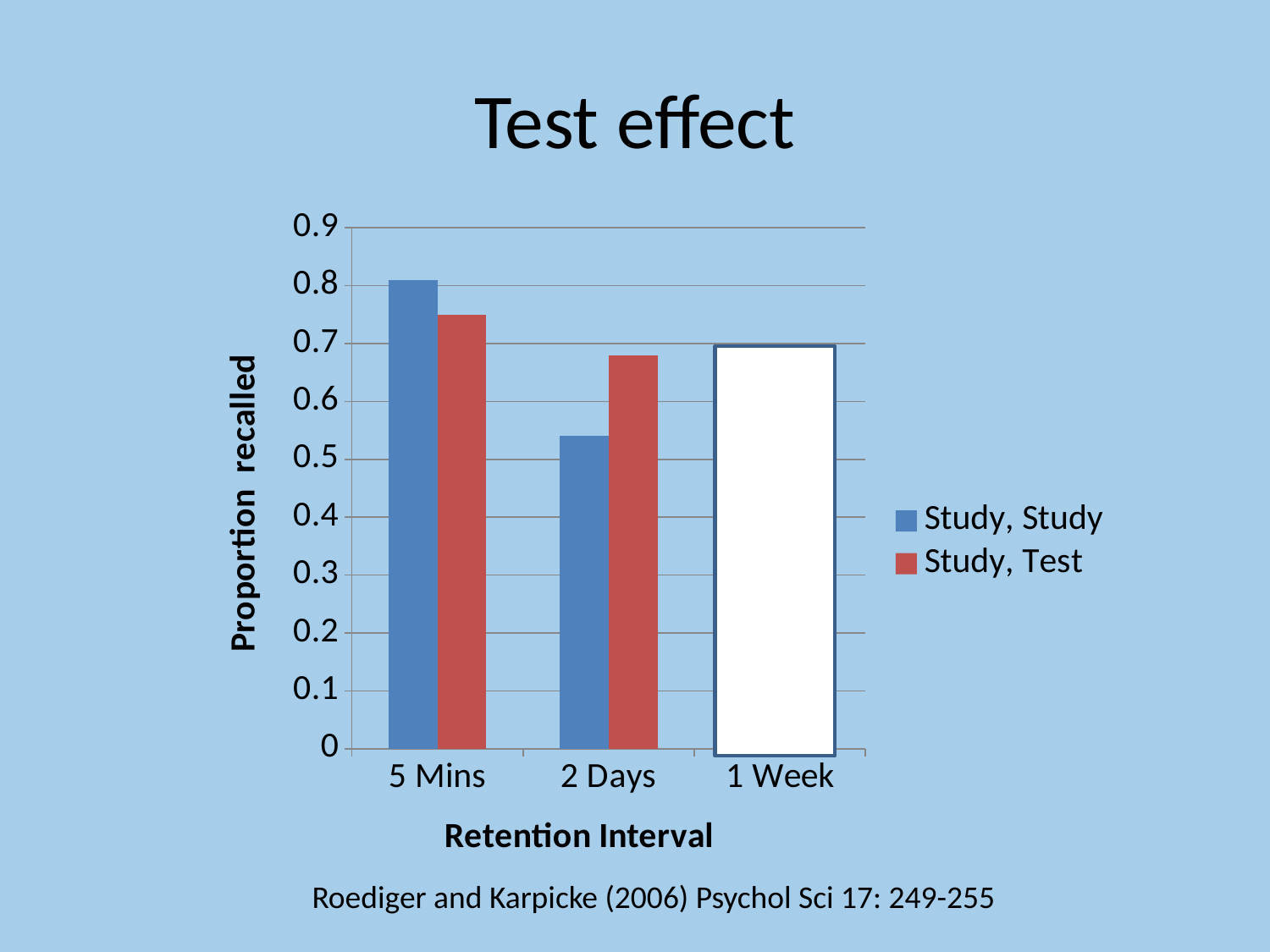
Is the value for Study, Study at 2 Days greater or less than 0.6? less How many retention interval categories are shown on the x axis? 3 What kind of chart is shown on the slide? bar chart How many series does the legend list? 2 What is the title of the chart? Test effect Is the value for Study, Test at 5 Mins greater or less than 0.8? less Is the value for Study, Study at 5 Mins greater or less than 0.7? greater At 2 Days, which series has the larger value, Study, Study or Study, Test? Study, Test What is the label of the y axis? Proportion recalled At 5 Mins, which series has the larger value, Study, Study or Study, Test? Study, Study Does the Study, Study series rise or fall from 5 Mins to 2 Days? fall